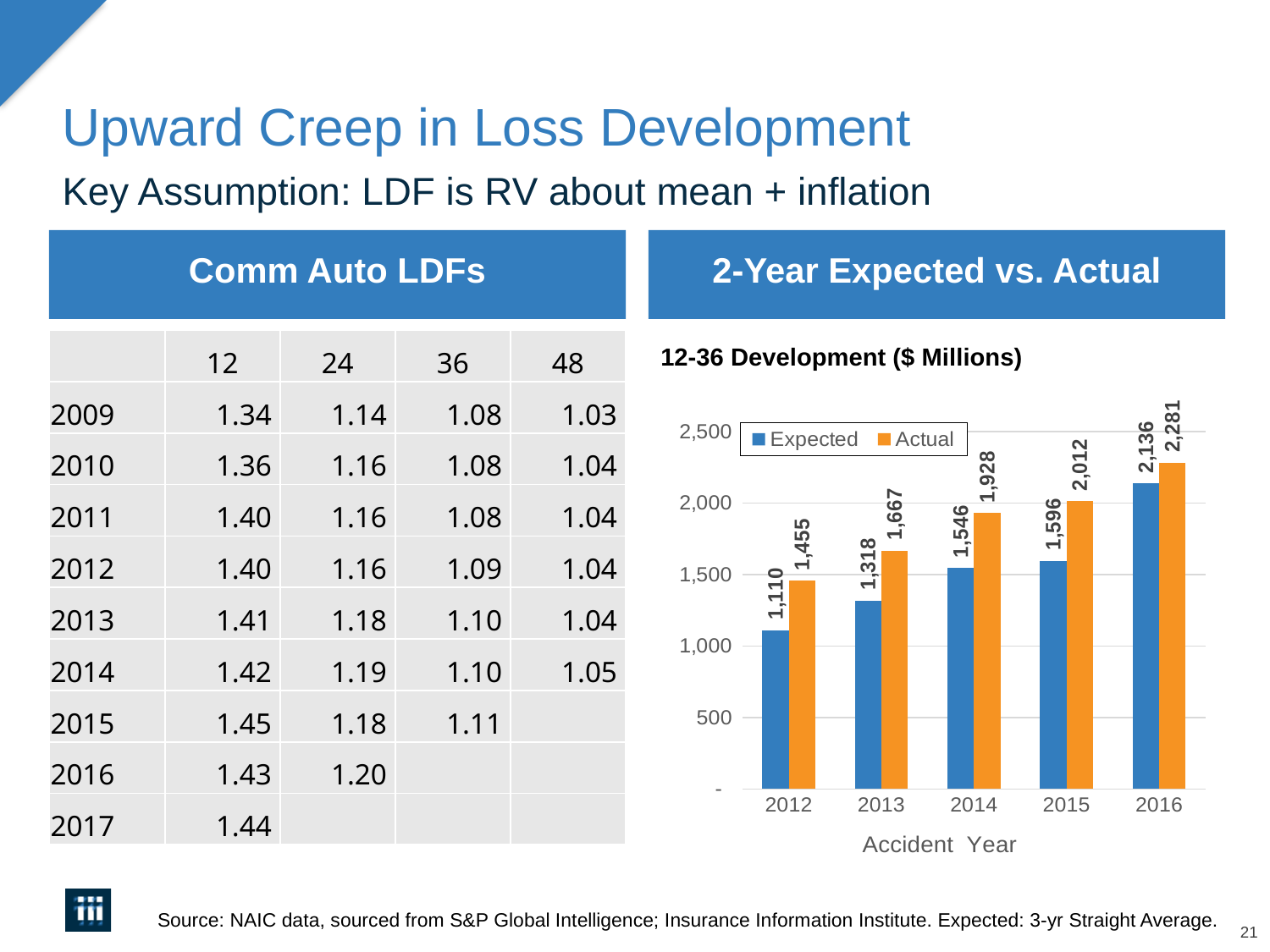
How many accident years are shown on the x axis of the 2-Year Expected vs. Actual chart? 5 How many series does the legend of the 2-Year Expected vs. Actual chart list? 2 In the 2-Year Expected vs. Actual chart, which is larger for 2013: the Expected value or the Actual value? Actual What is the Actual value for accident year 2016 in the 2-Year Expected vs. Actual chart? 2,281 Do the Actual values rise or fall from 2012 to 2016 in the 2-Year Expected vs. Actual chart? Rise What is the Expected value for accident year 2014 in the 2-Year Expected vs. Actual chart? 1,546 Which accident year has the highest Actual value in the 2-Year Expected vs. Actual chart? 2016 What is the Actual value for accident year 2012 in the 2-Year Expected vs. Actual chart? 1,455 What kind of chart is the 2-Year Expected vs. Actual chart? Bar chart What is the difference between the Actual and Expected values for accident year 2015 in the 2-Year Expected vs. Actual chart? 416 In the 2-Year Expected vs. Actual chart, is the Expected value for 2016 greater or less than 2,000? greater Which accident year has the lowest Expected value in the 2-Year Expected vs. Actual chart? 2012